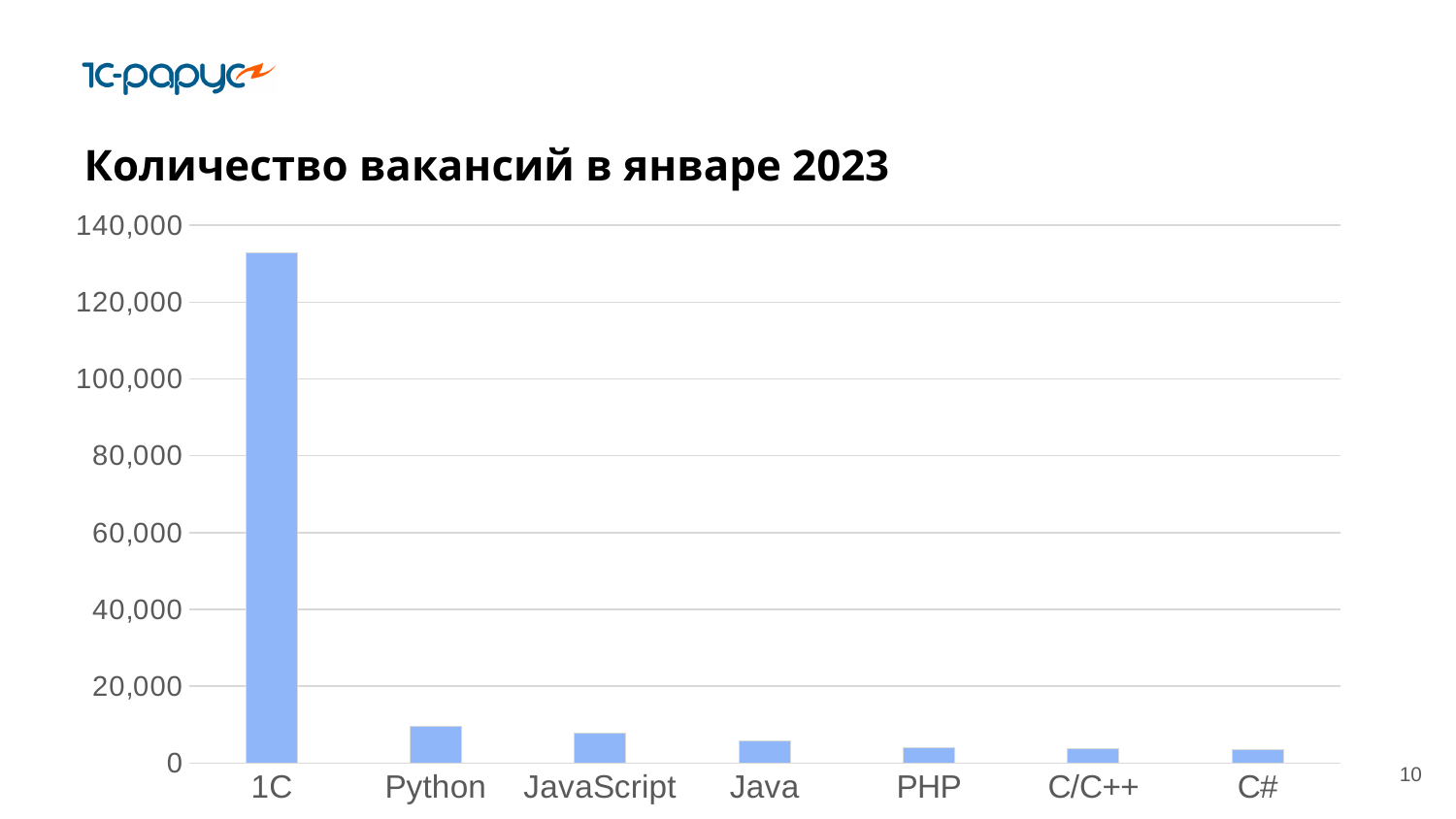
Which category has the highest number of vacancies? 1C What kind of chart is shown on the slide? bar chart Is the value for Python greater or less than 20,000? less Which has more vacancies, Python or Java? Python Do the values generally rise or fall from left to right along the x axis? fall What is the title of the chart? Количество вакансий в январе 2023 Which has more vacancies, 1C or Python? 1C Is the value for 1C greater or less than 120,000? greater What colour are the bars in the chart? blue How many categories are shown on the x axis of the chart? 7 Is the value for 1C greater or less than 140,000? less Which has more vacancies, JavaScript or C#? JavaScript